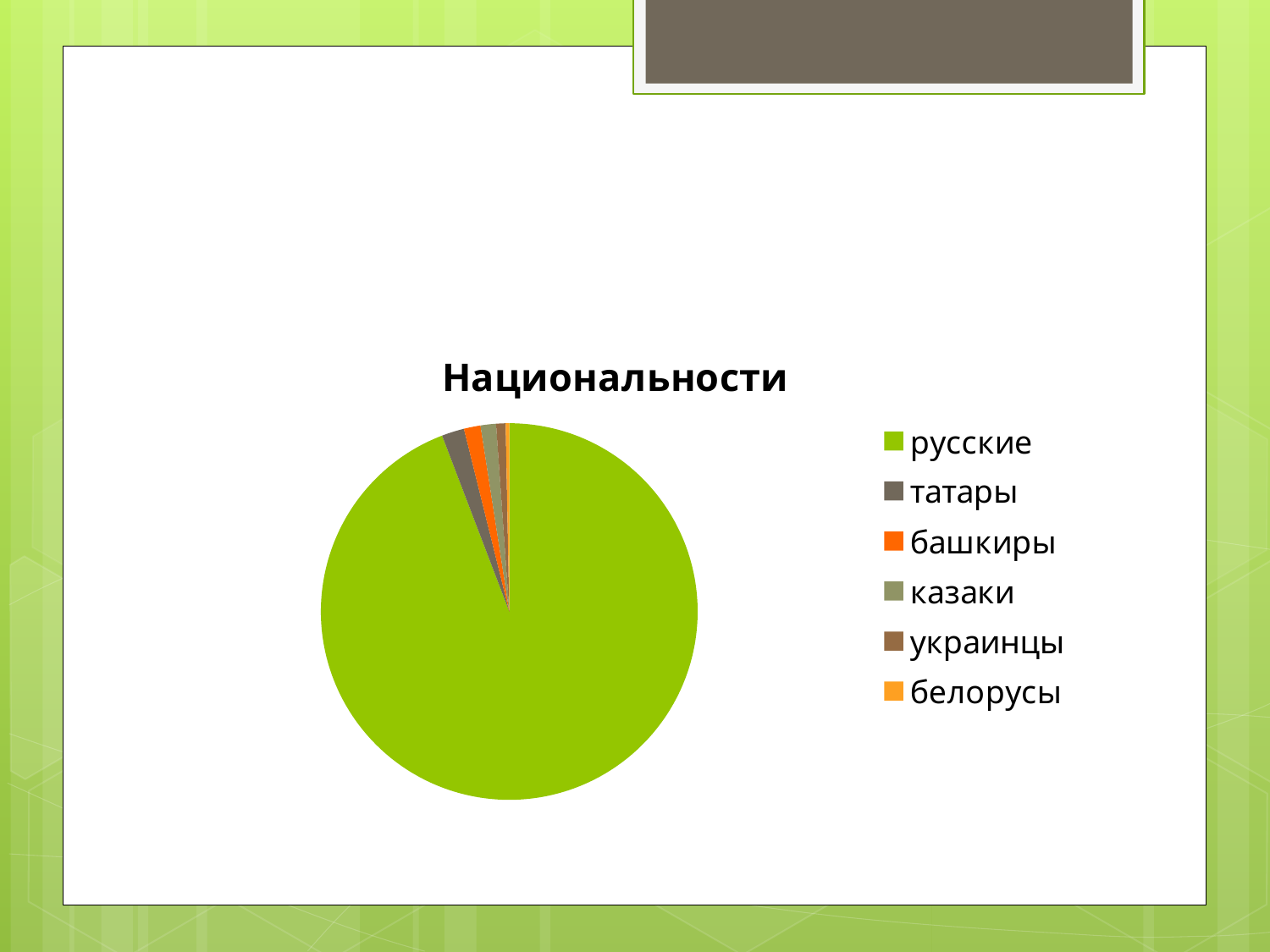
Which slice is larger, башкиры or русские? русские Which colour represents русские in the pie chart? green Which slice is larger, русские or татары? русские Which category is listed last in the legend? белорусы What kind of chart is shown on the slide? pie chart Which category has the largest slice of the pie? русские How many categories does the legend of the pie chart list? 6 What is the title of the chart? Национальности